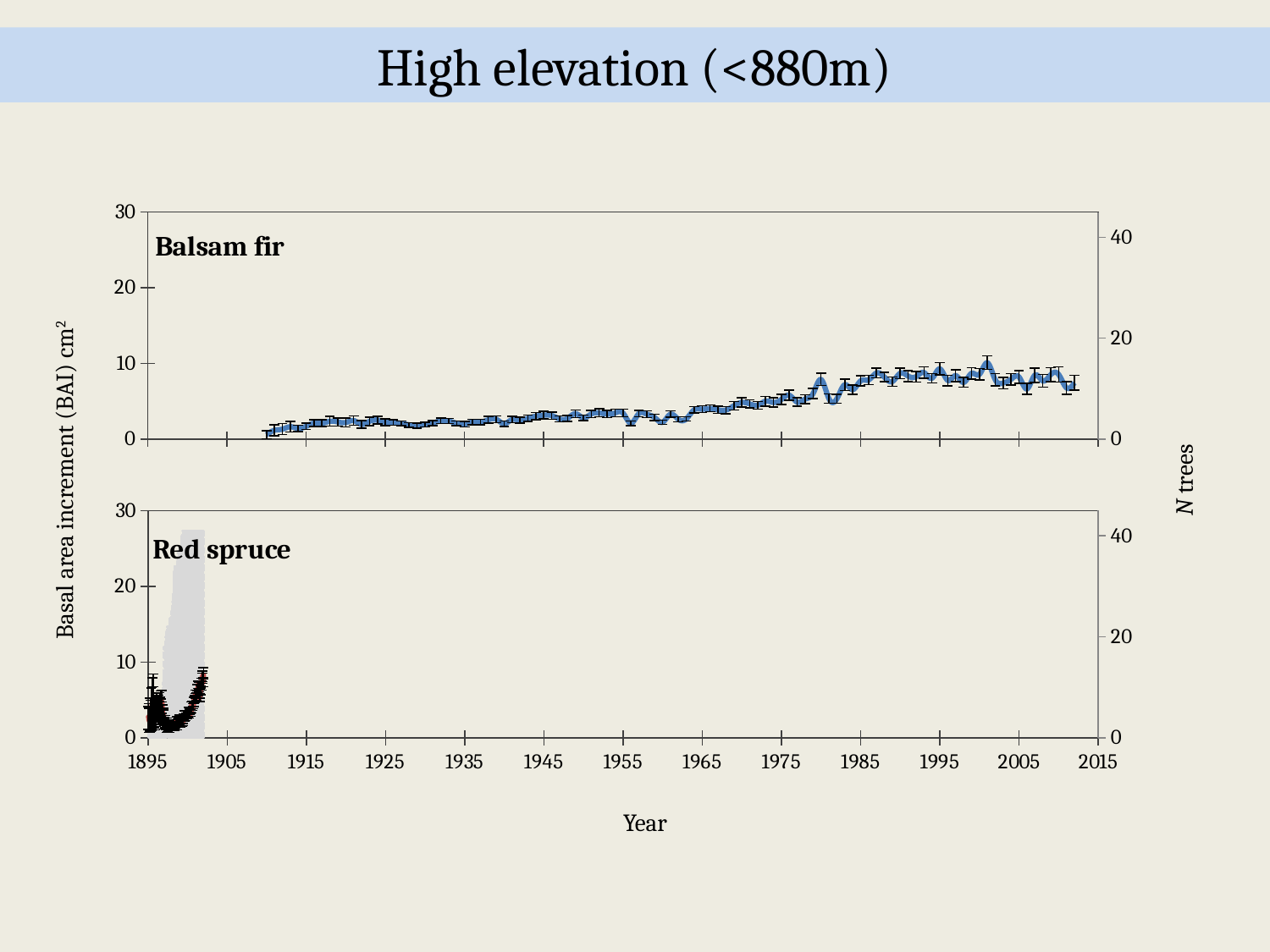
In the Balsam fir chart, is the value around 2005 larger than the value around 1915? yes In the Red spruce chart, is the value around 1895 greater or less than 10? less What kind of chart is the Balsam fir chart? line chart In the Red spruce chart, is the value around 1900 greater or less than 20? less In the Balsam fir chart, is the value around 1950 greater or less than 20? less What is the title of the slide? High elevation (<880m) In the Balsam fir chart, do the basal area increment values generally rise or fall from 1910 to 2010? rise What is the label of the x axis shared by the two charts? Year How many charts are shown on the slide? 2